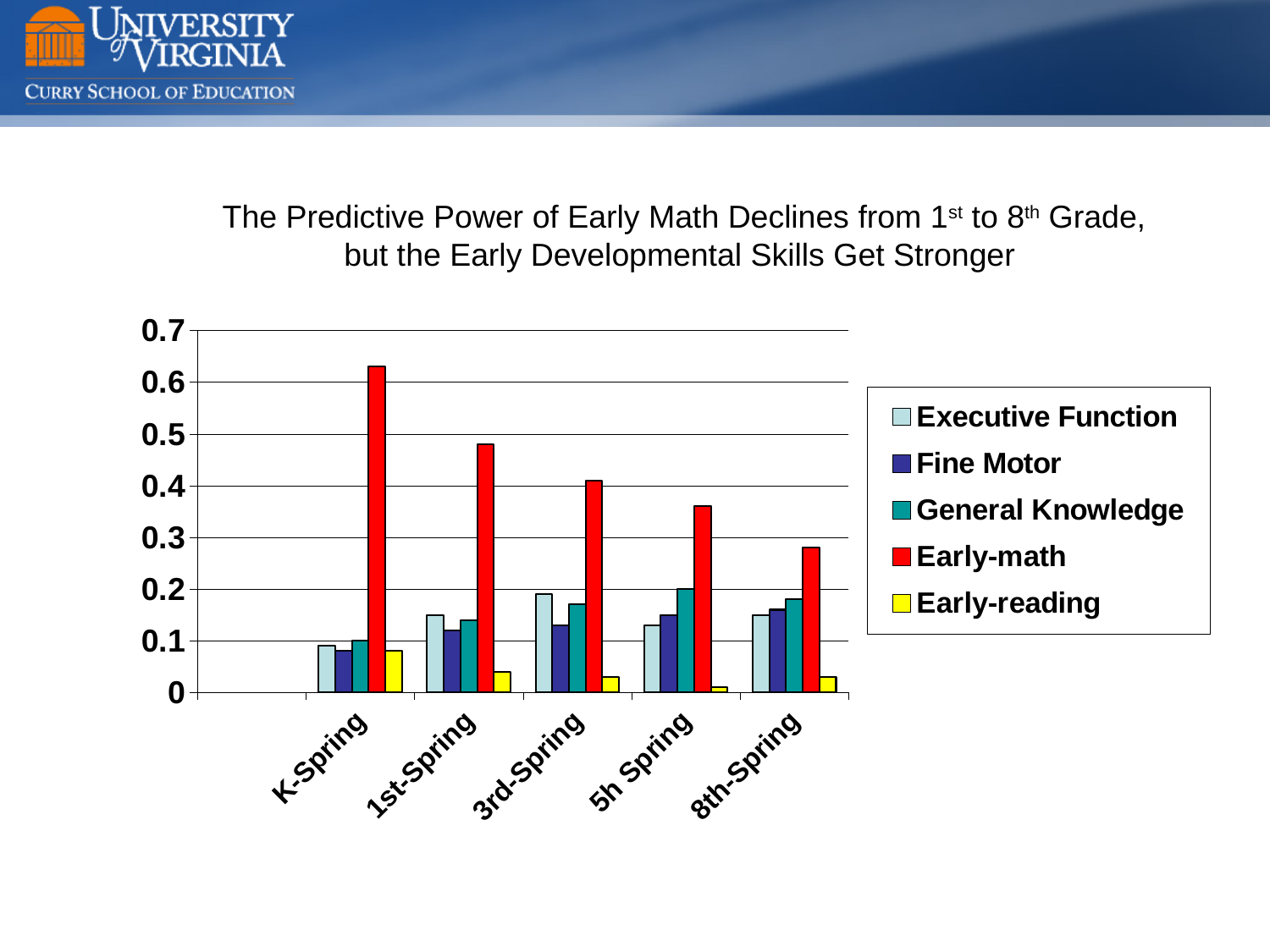
Which is larger at K-Spring, the Early-math value or the Early-reading value? Early-math In which category is the Early-math value highest? K-Spring How many categories are shown along the x axis of the chart? 5 What kind of chart is shown on the slide? bar chart Is the Early-reading value for K-Spring greater or less than 0.1? less What colour are the Early-math bars in the chart? red How many series does the chart's legend list? 5 Is the Early-math value for K-Spring greater or less than 0.5? greater In which category is the Early-math value lowest? 8th-Spring Which is larger for Executive Function, the value at K-Spring or the value at 3rd-Spring? 3rd-Spring Do the Early-math values rise or fall from K-Spring to 8th-Spring? fall Is the Early-math value for 3rd-Spring greater or less than 0.3? greater